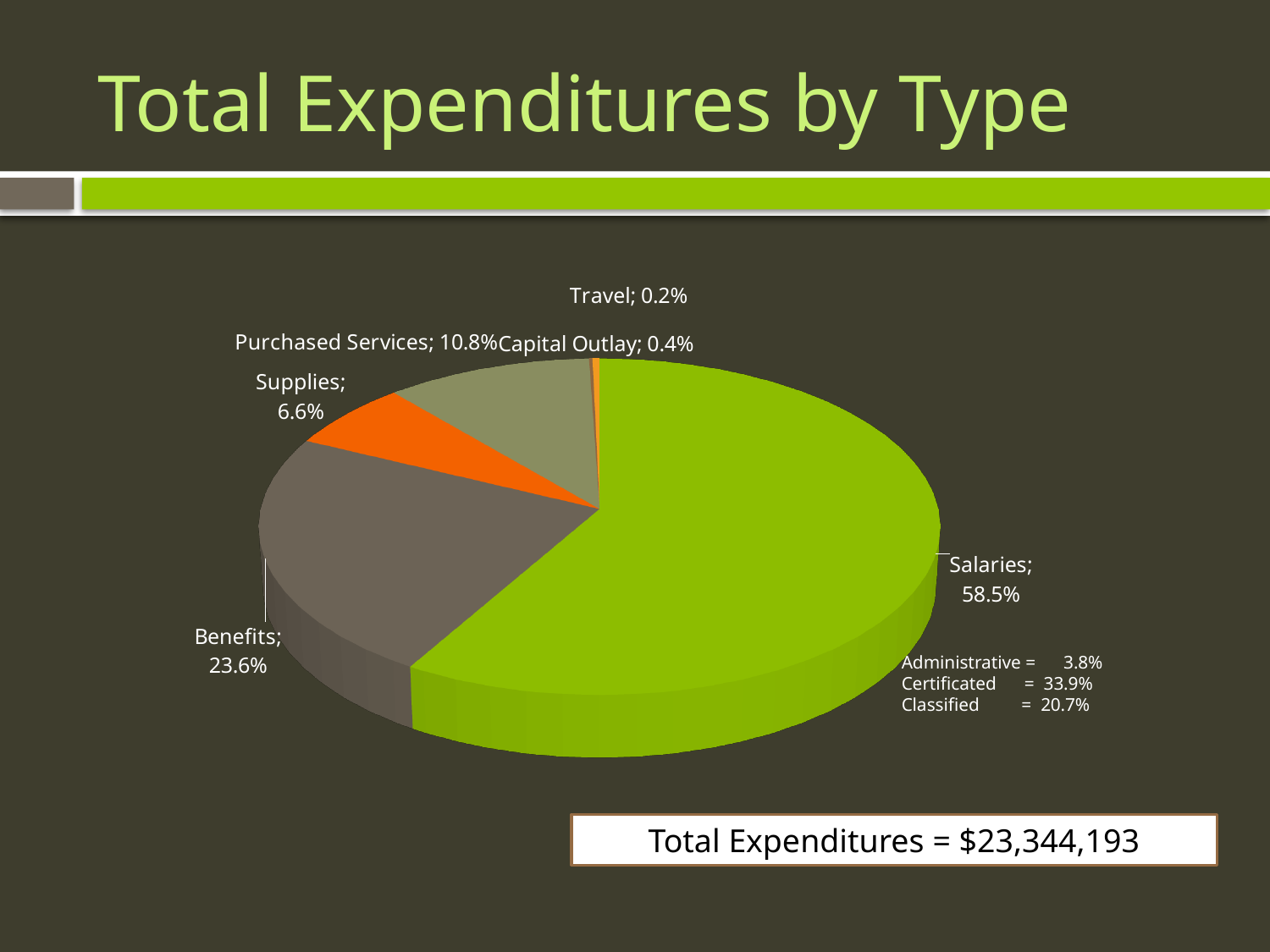
How many slices does the pie chart have? 6 What kind of chart is shown on the slide? Pie chart What share of total expenditures is Purchased Services? 10.8% What share of total expenditures is Supplies? 6.6% Which has a larger share, Purchased Services or Supplies? Purchased Services What share of total expenditures is Capital Outlay? 0.4% Which expenditure type has the largest share of the pie? Salaries What is the total expenditures amount shown on the slide? $23,344,193 What share of total expenditures is Salaries? 58.5% What is the difference in percentage points between the Salaries share and the Benefits share? 34.9 Which expenditure type has the smallest share of the pie? Travel What share of total expenditures is Benefits? 23.6%